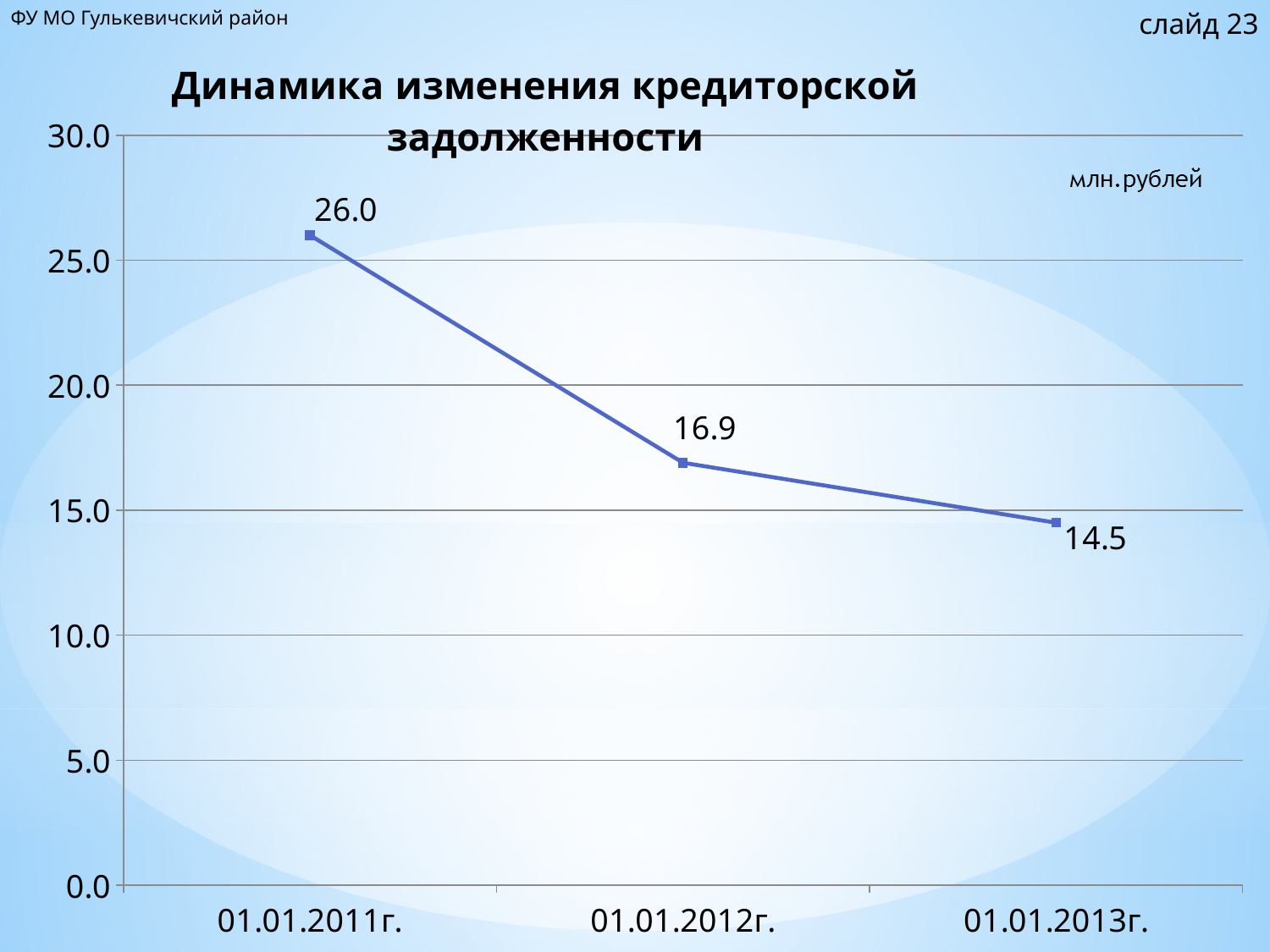
What is the difference between the values for 01.01.2011г. and 01.01.2012г.? 9.1 Do the values rise or fall from 01.01.2011г. to 01.01.2013г.? fall What is the value for 01.01.2011г.? 26.0 What kind of chart is shown on the slide? line chart Is the value for 01.01.2011г. greater or less than 25.0? greater What is the value for 01.01.2012г.? 16.9 What is the difference between the values for 01.01.2012г. and 01.01.2013г.? 2.4 What is the value for 01.01.2013г.? 14.5 Which date has the lowest value? 01.01.2013г. How many data points are plotted on the chart? 3 Which date has the highest value? 01.01.2011г. Which is larger, the value for 01.01.2012г. or for 01.01.2013г.? 01.01.2012г.